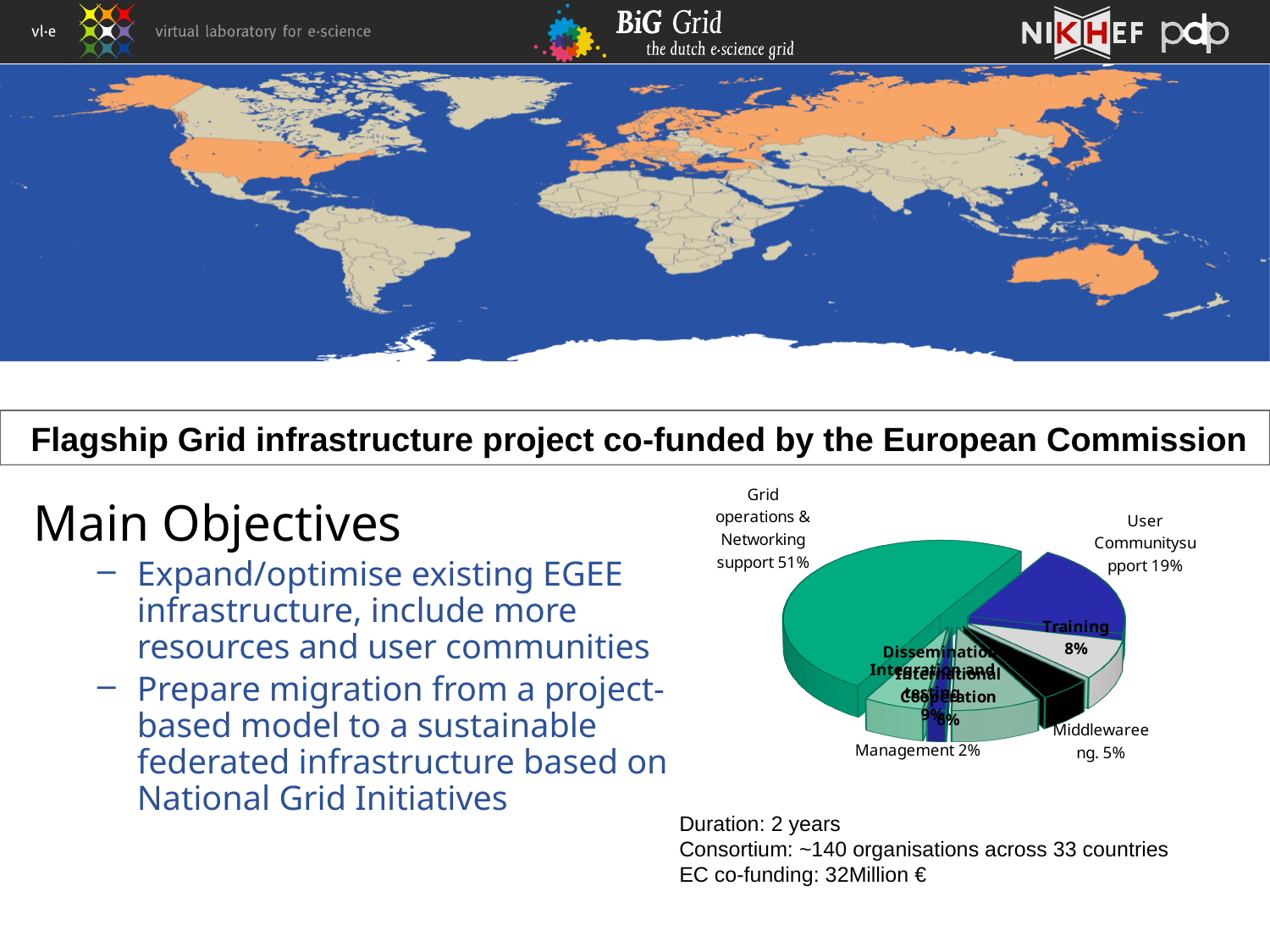
How many percentage points larger is Grid operations & Networking support than User Community support? 32 percentage points What is the difference between the Training and Management shares? 6 percentage points What share of the pie does Grid operations & Networking support have? 51% What percentage is shown for Middleware eng. in the pie chart? 5% Which is larger in the pie chart, Training or Middleware eng.? Training What percentage is shown for Management in the pie chart? 2% Which labelled category has the smallest slice of the pie? Management Which category has the largest slice of the pie? Grid operations & Networking support What colour is the Grid operations & Networking support slice? green What percentage is shown for Training in the pie chart? 8% What share of the pie does User Community support have? 19% What kind of chart is shown on the slide? pie chart